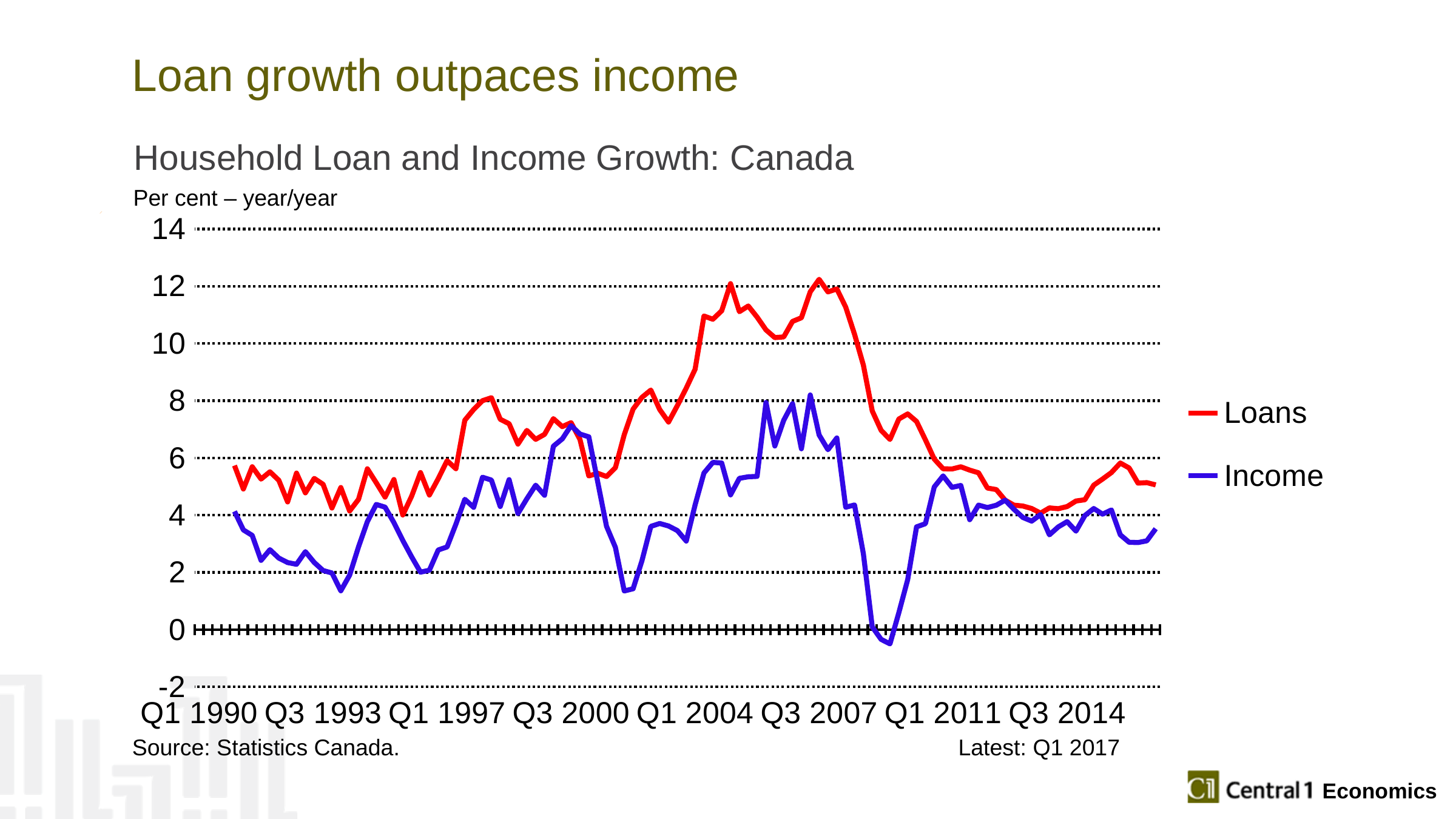
Is the value for Loans at Q1 2004 greater or less than 10? less Which series reaches the lowest value on the chart? Income Does the Loans line rise or fall between Q3 2007 and Q1 2011? fall Which series reaches the highest value on the chart? Loans Is the value for Loans at Q3 2007 greater or less than 10? greater Is the value for Loans at Q3 2014 greater or less than 6? less What is the title of the chart? Household Loan and Income Growth: Canada What kind of chart is shown on the slide? line chart Which colour is used for the Income series? blue How many series does the legend list? 2 At Q1 2004, which series has the larger value, Loans or Income? Loans